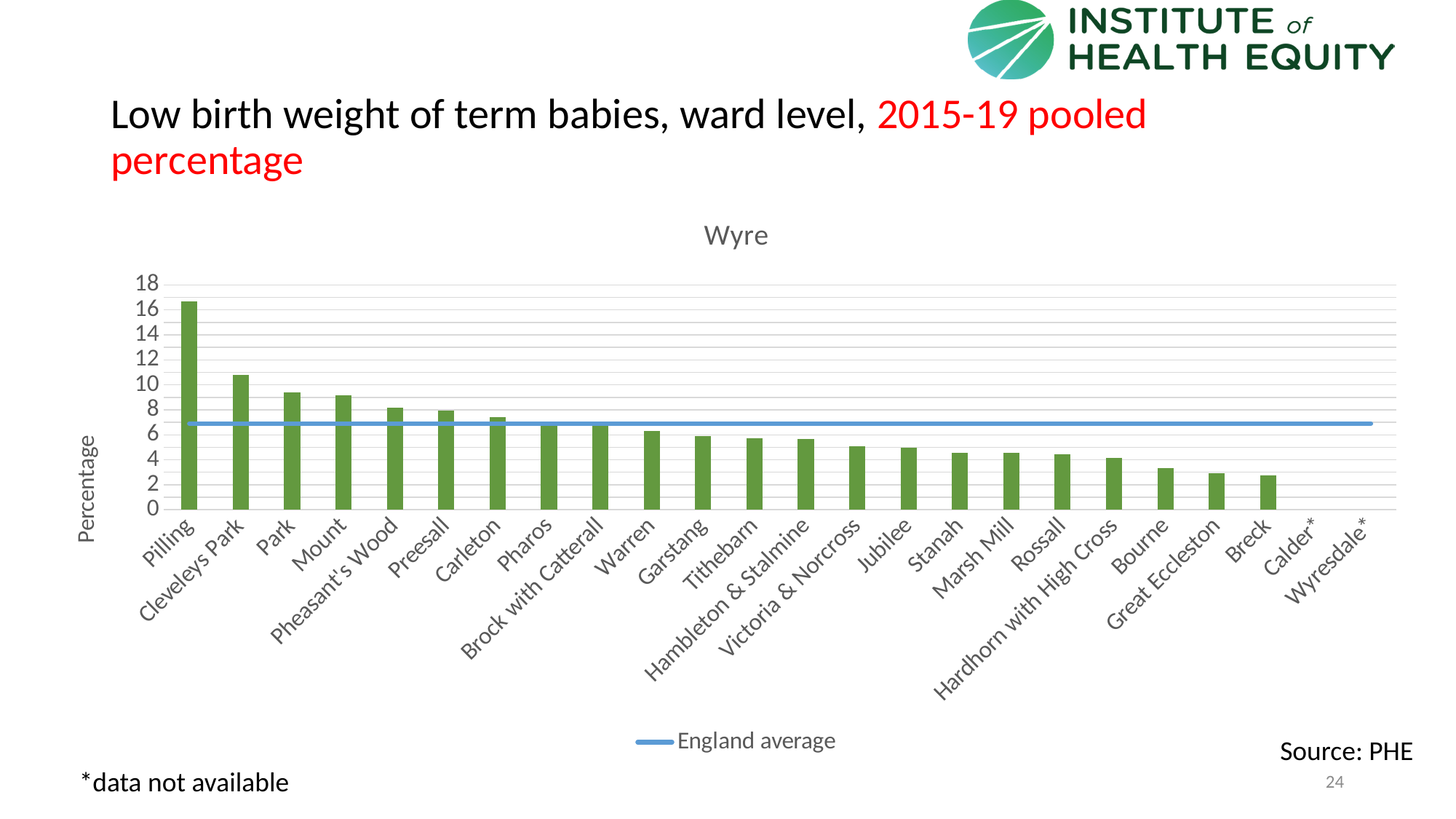
Do the bar values rise or fall from left to right along the x axis? fall Is the value for Bourne greater or less than 4? less What kind of chart is shown on the slide? bar chart Is the value for Pilling greater or less than 14? greater Is the value for Jubilee greater or less than 6? less Which ward has the highest low birth weight percentage? Pilling What does the blue horizontal line in the chart represent, according to the legend? England average Which has a higher value, Pilling or Cleveleys Park? Pilling Which has a higher value, Preesall or Carleton? Preesall How many wards are listed on the x axis of the chart? 24